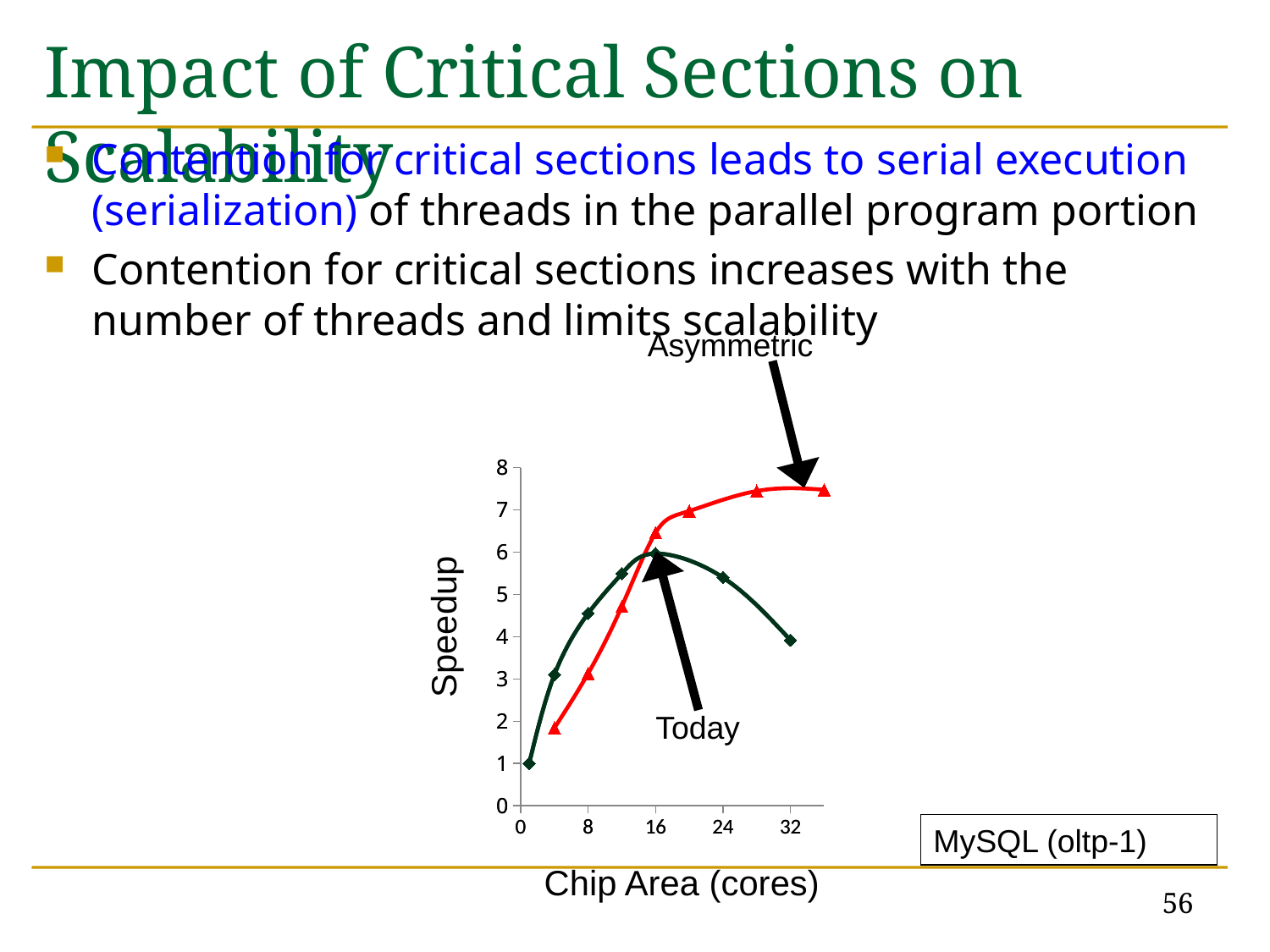
Is the speedup of the Asymmetric line at 8 cores greater or less than 4? less What kind of chart is shown on the slide? line chart At which chip area (cores) does the Today line reach its highest speedup? 16 What is the label of the y axis of the chart? Speedup At 8 cores, which line has the higher speedup, Today or Asymmetric? Today At 24 cores, which line has the higher speedup, Today or Asymmetric? Asymmetric How many data points are plotted on the Today line? 7 Is the speedup of the Today line at 32 cores greater or less than 5? less Is the speedup of the Asymmetric line at its rightmost point greater or less than 7? greater What is the label of the x axis of the chart? Chip Area (cores) Does the speedup of the Today line rise or fall between 16 and 32 cores? fall How many lines are plotted in the chart? 2